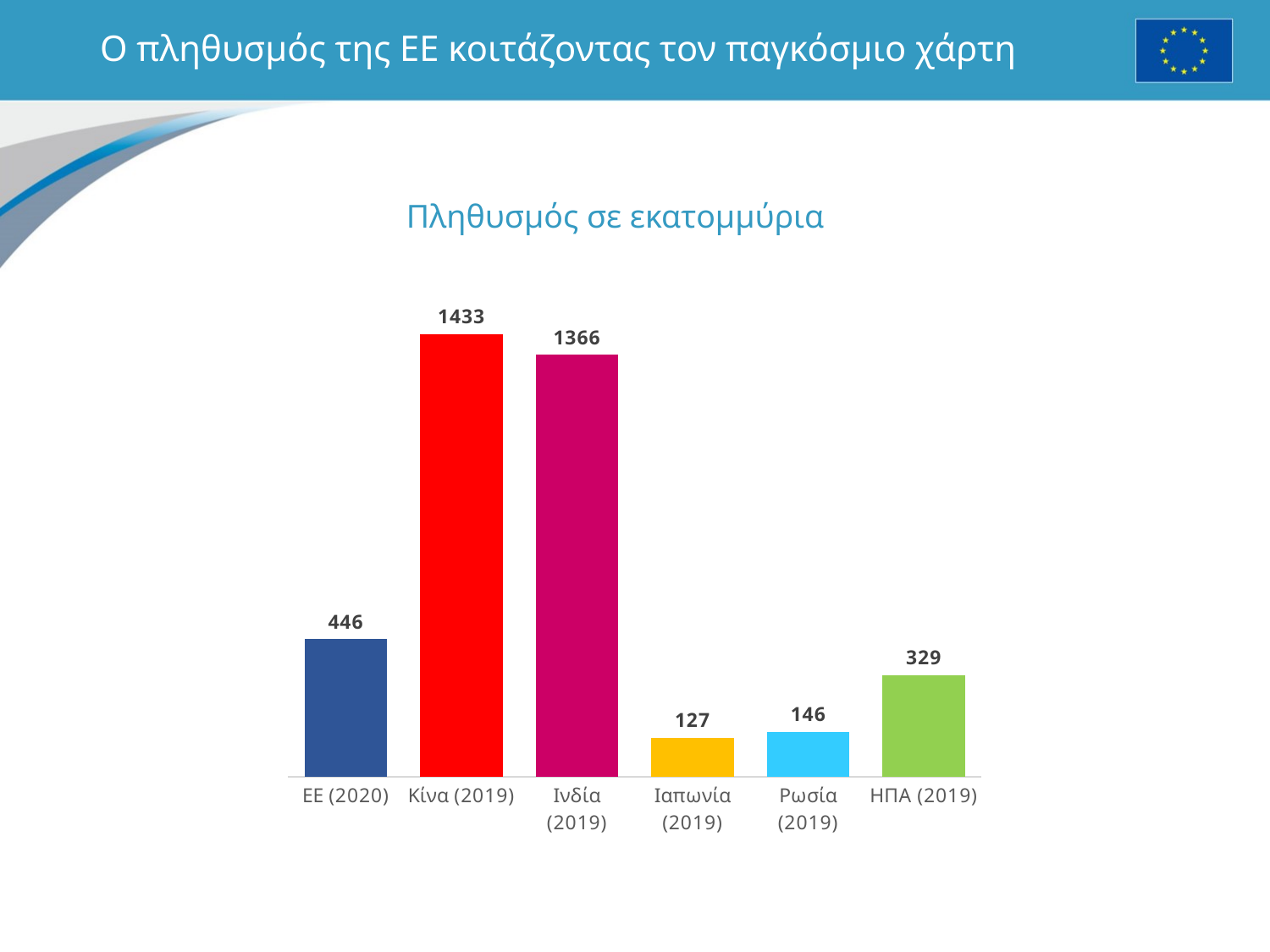
What is the population value shown for Ιαπωνία (2019)? 127 Which category has the highest population in the chart? Κίνα (2019) Which category has the lowest population in the chart? Ιαπωνία (2019) Which is larger, the value for Ρωσία (2019) or the value for Ιαπωνία (2019)? Ρωσία (2019) How many categories are shown in the chart? 6 What kind of chart is shown on the slide? Bar chart What is the difference between the values for Κίνα (2019) and Ινδία (2019)? 67 What is the difference between the values for ΕΕ (2020) and ΗΠΑ (2019)? 117 What is the title of the chart? Πληθυσμός σε εκατομμύρια What is the population value shown for Κίνα (2019)? 1433 What is the population value shown for ΗΠΑ (2019)? 329 What is the population value shown for ΕΕ (2020)? 446